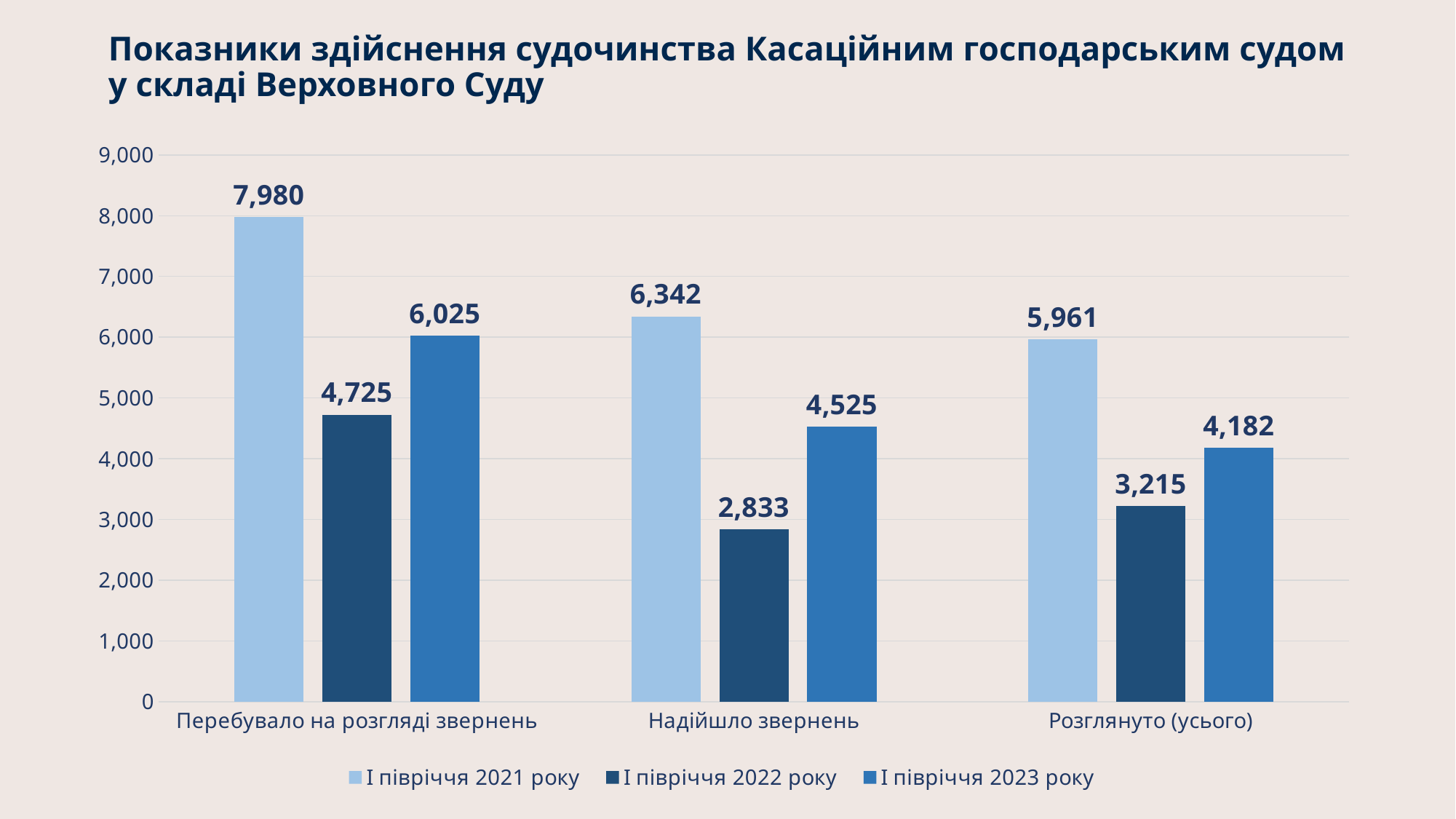
What is the value for «Перебувало на розгляді звернень» in І півріччя 2021 року? 7,980 How many series does the legend list? 3 What is the value for «Надійшло звернень» in І півріччя 2022 року? 2,833 What kind of chart is shown on the slide? Bar chart Which category has the lowest value in І півріччя 2022 року? Надійшло звернень Which category has the highest value in І півріччя 2021 року? Перебувало на розгляді звернень What is the value for «Розглянуто (усього)» in І півріччя 2023 року? 4,182 Is the value for «Надійшло звернень» in І півріччя 2021 року greater or less than 6,000? greater Which is larger for «Розглянуто (усього)»: І півріччя 2022 року or І півріччя 2023 року? І півріччя 2023 року How many categories are shown on the x axis? 3 What is the difference between the І півріччя 2021 року and І півріччя 2022 року values for «Перебувало на розгляді звернень»? 3,255 What is the difference between the І півріччя 2023 року and І півріччя 2022 року values for «Надійшло звернень»? 1,692